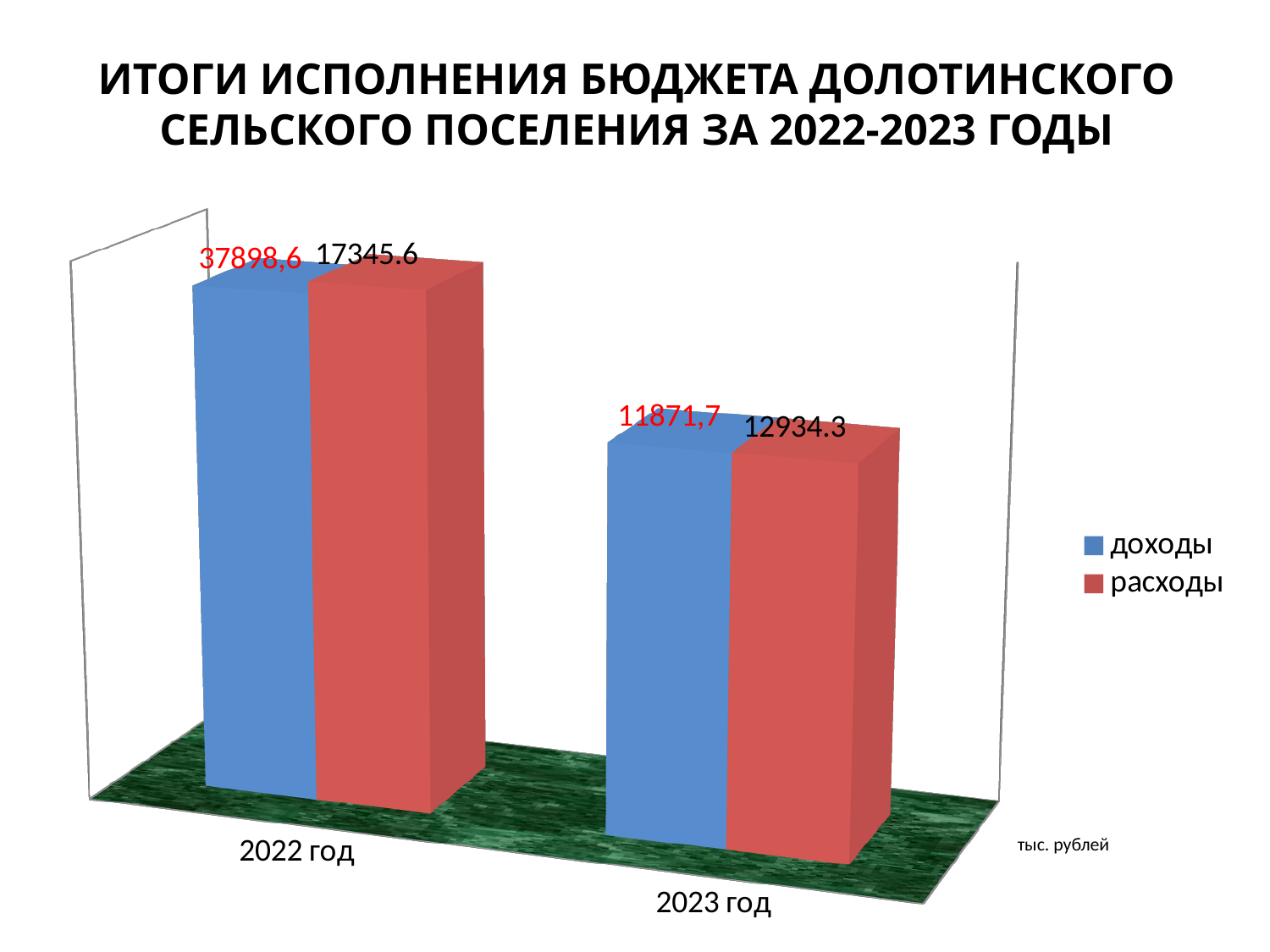
What is the value of расходы for 2022 год? 17345.6 What kind of chart is shown on the slide? bar chart What is the value of расходы for 2023 год? 12934.3 Which colour represents расходы in the legend? red Do the расходы values rise or fall from 2022 год to 2023 год? fall What is the difference between расходы in 2022 год and расходы in 2023 год? 4411.3 In which year is расходы higher, 2022 год or 2023 год? 2022 год How many years (categories) are shown on the chart? 2 What is the value of доходы for 2023 год? 11871,7 For 2023 год, which is larger, доходы or расходы? расходы What is the value of доходы for 2022 год? 37898,6 How many series does the legend list? 2